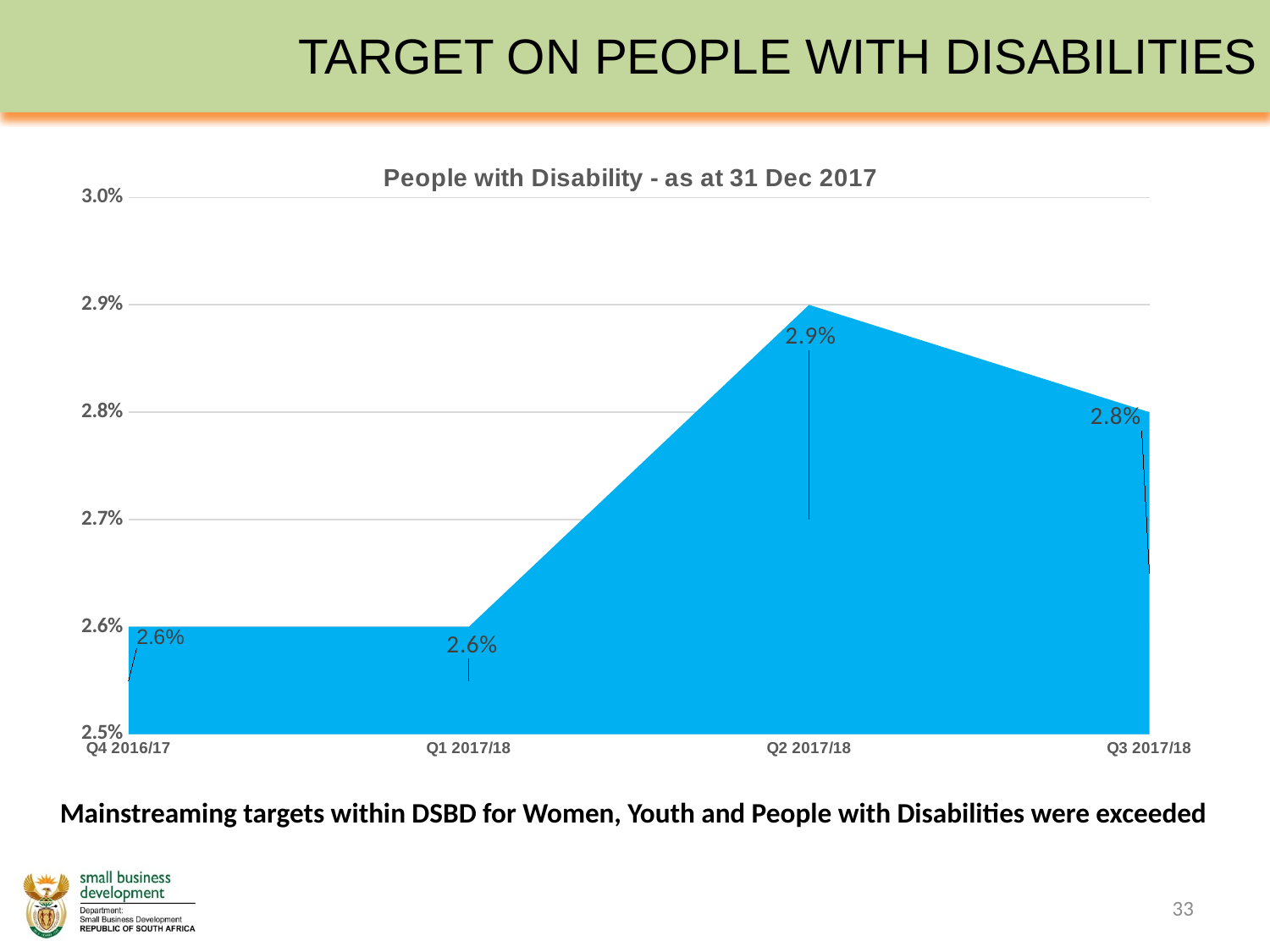
How many quarters are plotted on the chart? 4 Is the value for Q2 2017/18 greater or less than 2.7%? greater What is the value for Q4 2016/17? 2.6% What is the difference between the values for Q2 2017/18 and Q3 2017/18? 0.1% What is the value for Q1 2017/18? 2.6% Which is larger, the value for Q3 2017/18 or the value for Q4 2016/17? Q3 2017/18 What is the value for Q2 2017/18? 2.9% What kind of chart is shown on the slide? Area chart What is the value for Q3 2017/18? 2.8% What is the title of the chart? People with Disability - as at 31 Dec 2017 Which quarter has the highest value? Q2 2017/18 What is the difference between the values for Q2 2017/18 and Q1 2017/18? 0.3%